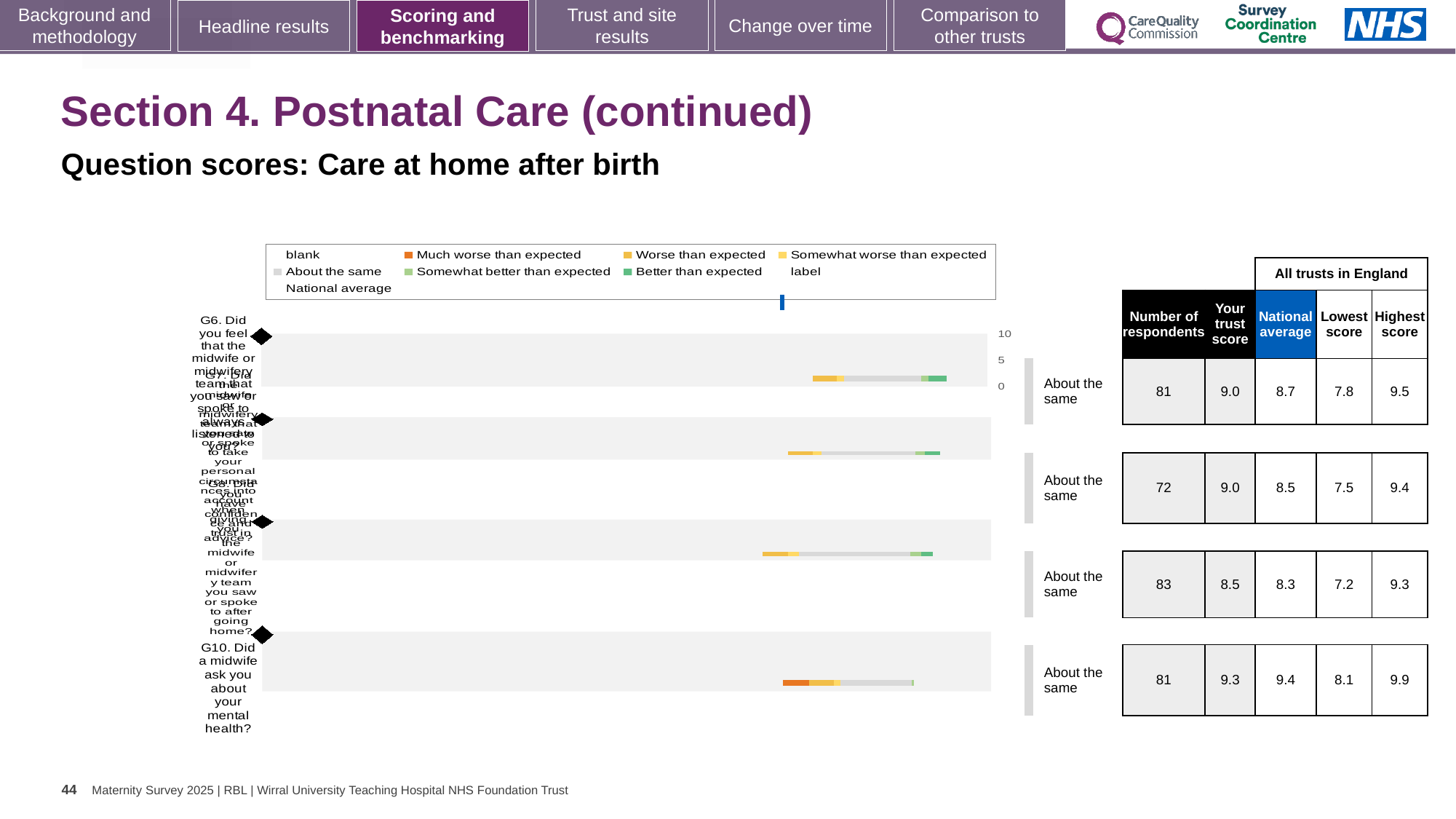
What kind of chart is shown on the slide? bar chart What colour represents 'Better than expected' in the chart legend? green What is the label of the bottom bar in the chart? G10. Did a midwife ask you about your mental health? How many bars (question categories) are plotted in the chart? 4 What is the highest value shown on the chart's axis? 10 What colour represents 'Much worse than expected' in the chart legend? orange